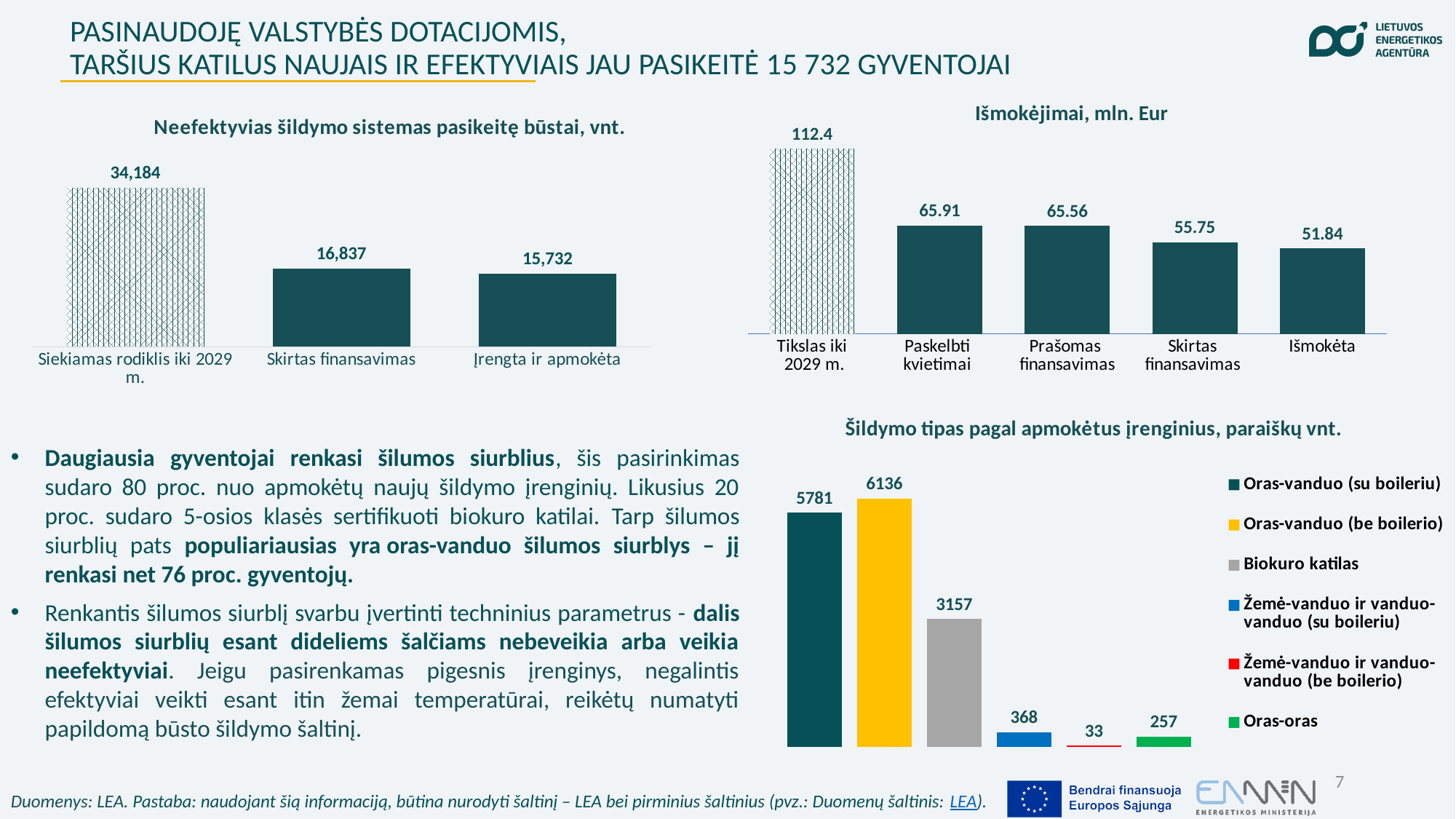
In the chart 'Išmokėjimai, mln. Eur', what is the value for 'Išmokėta'? 51.84 In the chart 'Neefektyvias šildymo sistemas pasikeitę būstai, vnt.', what is the value for 'Įrengta ir apmokėta'? 15,732 In the chart 'Šildymo tipas pagal apmokėtus įrenginius, paraiškų vnt.', how many entries does the legend list? 6 In the chart 'Šildymo tipas pagal apmokėtus įrenginius, paraiškų vnt.', which heating type has the highest value? Oras-vanduo (be boilerio) In the chart 'Neefektyvias šildymo sistemas pasikeitę būstai, vnt.', which category has the highest value? Siekiamas rodiklis iki 2029 m. In the chart 'Išmokėjimai, mln. Eur', what is the difference between 'Tikslas iki 2029 m.' and 'Paskelbti kvietimai'? 46.49 In the chart 'Neefektyvias šildymo sistemas pasikeitę būstai, vnt.', what is the difference between 'Siekiamas rodiklis iki 2029 m.' and 'Skirtas finansavimas'? 17,347 In the chart 'Išmokėjimai, mln. Eur', how many categories are shown? 5 In the chart 'Išmokėjimai, mln. Eur', which category has the lowest value? Išmokėta What kind of chart is 'Išmokėjimai, mln. Eur'? Bar chart In the chart 'Šildymo tipas pagal apmokėtus įrenginius, paraiškų vnt.', what is the value for 'Biokuro katilas'? 3157 In the chart 'Šildymo tipas pagal apmokėtus įrenginius, paraiškų vnt.', which is larger: 'Žemė-vanduo ir vanduo-vanduo (su boileriu)' or 'Oras-oras'? Žemė-vanduo ir vanduo-vanduo (su boileriu)